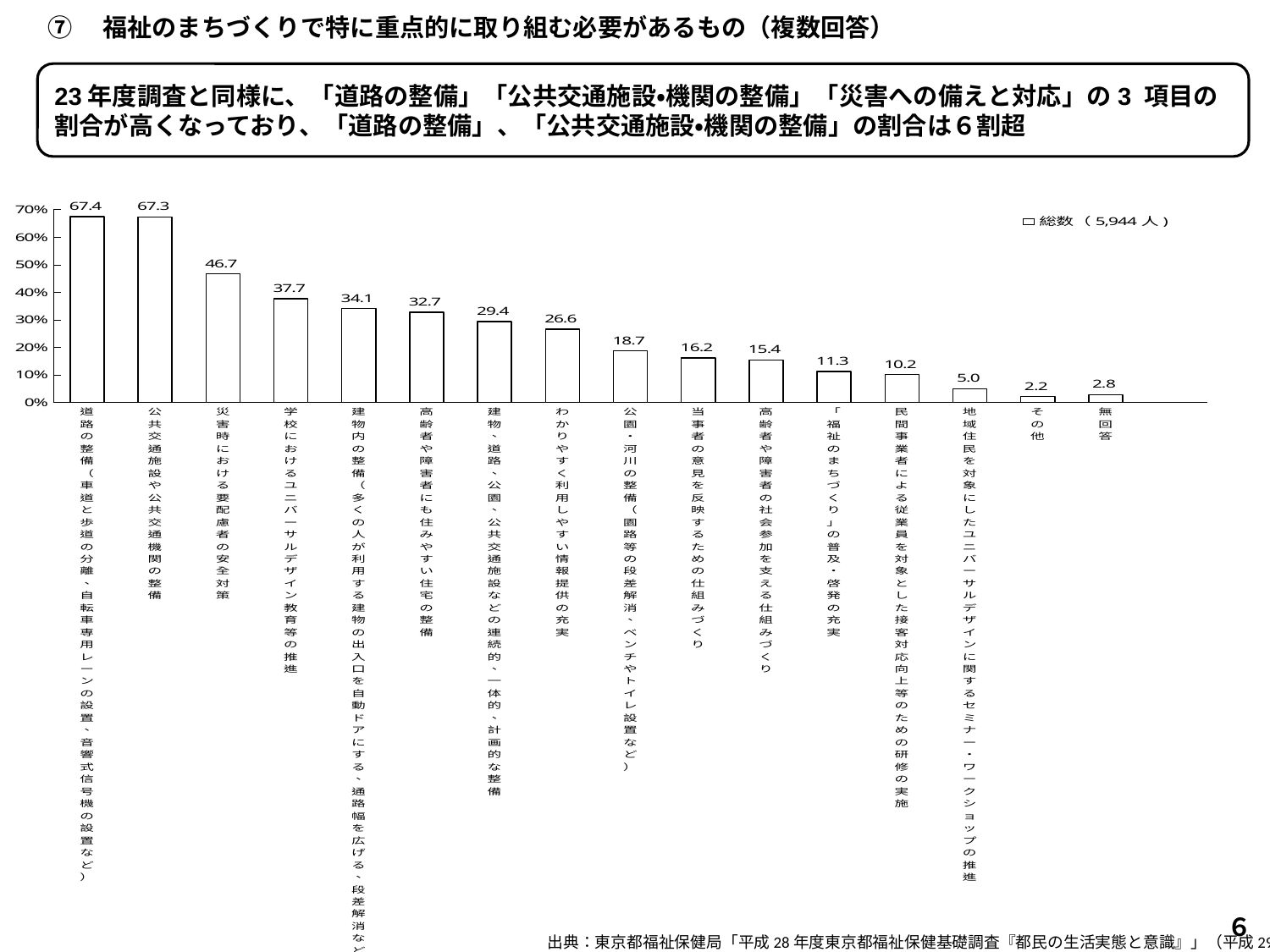
Is the value for 公園・河川の整備 greater or less than 20%? less What is the value for 災害時における要配慮者の安全対策? 46.7 What is the value for 道路の整備? 67.4 Which category has the highest value? 道路の整備 What is the value for 「福祉のまちづくり」の普及・啓発の充実? 11.3 How many categories are shown on the x axis? 16 What is the difference between the values for 道路の整備 and 災害時における要配慮者の安全対策? 20.7 Which category has the lowest value? その他 What series name does the legend show? 総数（5,944人） What is the value for 無回答? 2.8 Which is larger, the value for 学校におけるユニバーサルデザイン教育等の推進 or the value for 高齢者や障害者にも住みやすい住宅の整備? 学校におけるユニバーサルデザイン教育等の推進 What kind of chart is shown on the slide? bar chart